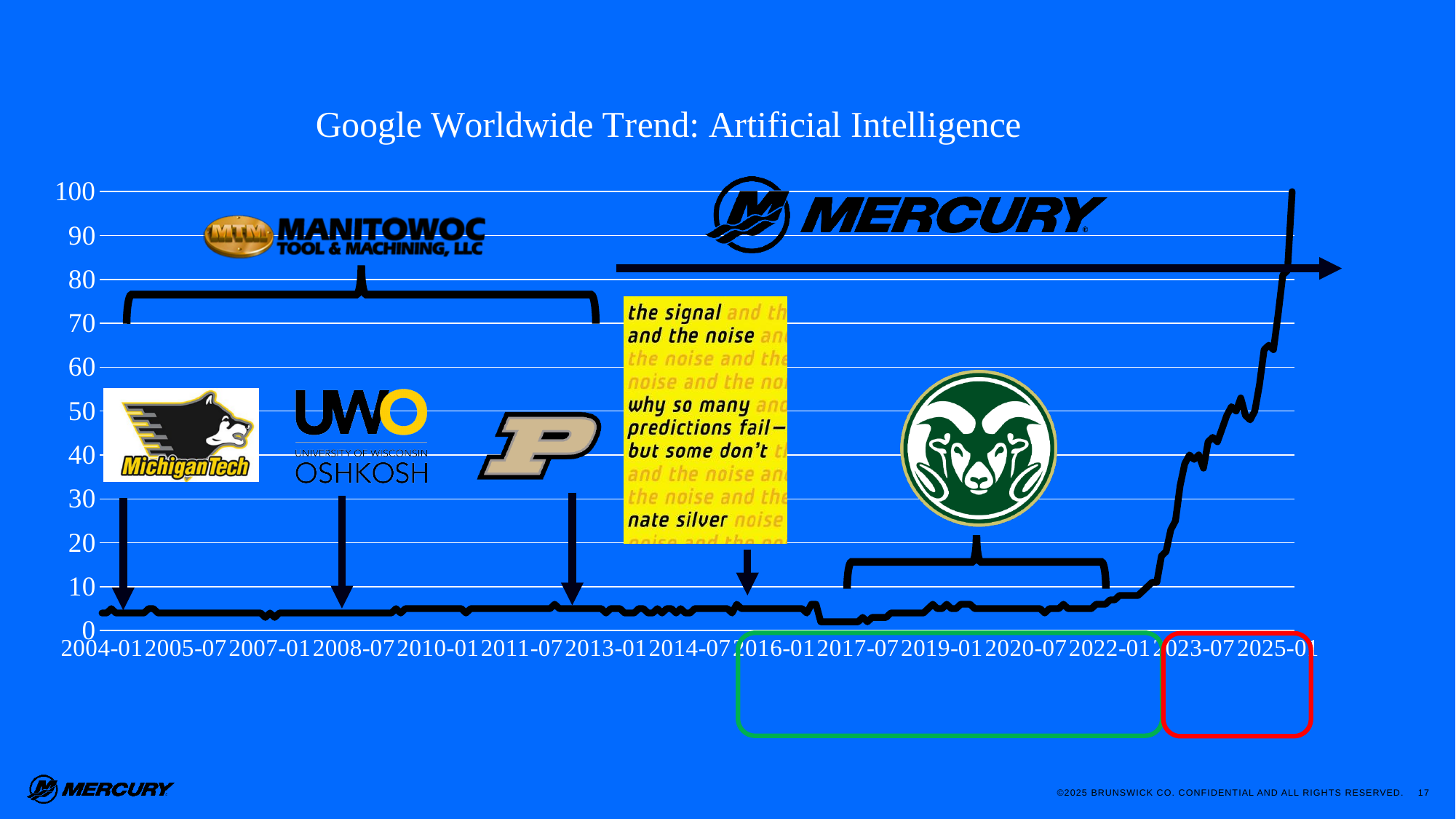
Is the value for 2023-07 greater or less than 30? greater What is the title of the chart? Google Worldwide Trend: Artificial Intelligence What is the highest value shown on the vertical axis? 100 Is the value for 2022-01 greater or less than 20? less Does the line rise or fall overall from 2004-01 to 2025-01? rise What kind of chart is shown on the slide? line chart Is the peak value of the line greater or less than 90? greater Which is larger, the value for 2023-07 or the value for 2010-01? 2023-07 How many date labels are shown along the x axis? 15 Near which end of the x axis does the line reach its highest value? the right end (2025-01)